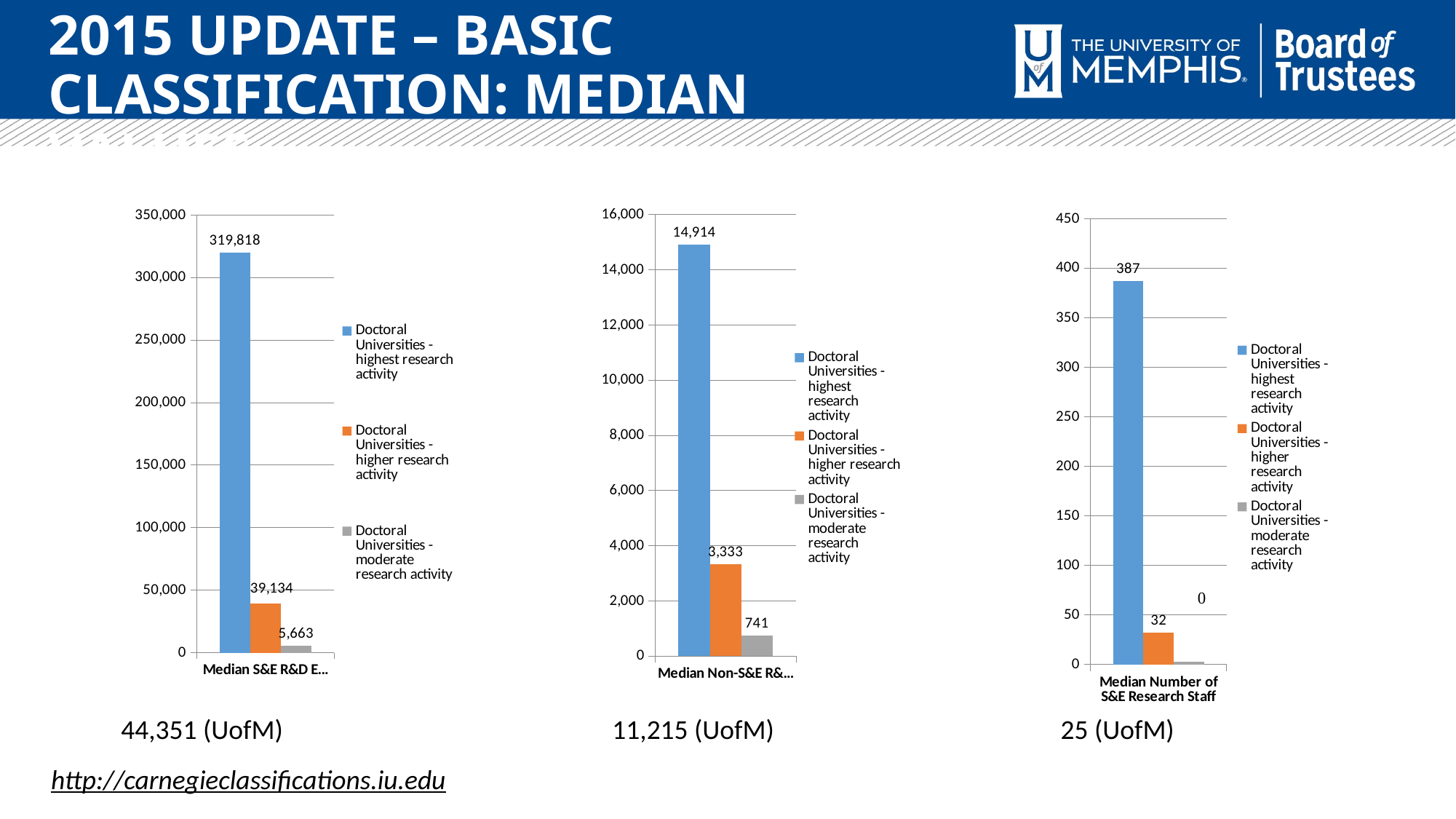
In the middle chart (Median Non-S&E R&...), what is the difference between the higher research activity and moderate research activity values? 2,592 In the middle chart (Median Non-S&E R&...), which series has the lowest value? Doctoral Universities - moderate research activity In the left chart (Median S&E R&D E...), is the value for Doctoral Universities - higher research activity greater or less than 50,000? less In the left chart (Median S&E R&D E...), what is the difference between the highest research activity and higher research activity values? 280,684 In the middle chart (Median Non-S&E R&...), what is the value for Doctoral Universities - higher research activity? 3,333 In the right chart (Median Number of S&E Research Staff), which series has the highest value? Doctoral Universities - highest research activity In the left chart (Median S&E R&D E...), what is the value for Doctoral Universities - highest research activity? 319,818 In the right chart (Median Number of S&E Research Staff), what is the value for Doctoral Universities - higher research activity? 32 What kind of chart is the left chart (Median S&E R&D E...)? Bar chart How many series does the legend of the middle chart (Median Non-S&E R&...) list? 3 In the left chart (Median S&E R&D E...), what is the value for Doctoral Universities - moderate research activity? 5,663 In the right chart (Median Number of S&E Research Staff), what is the value for Doctoral Universities - highest research activity? 387